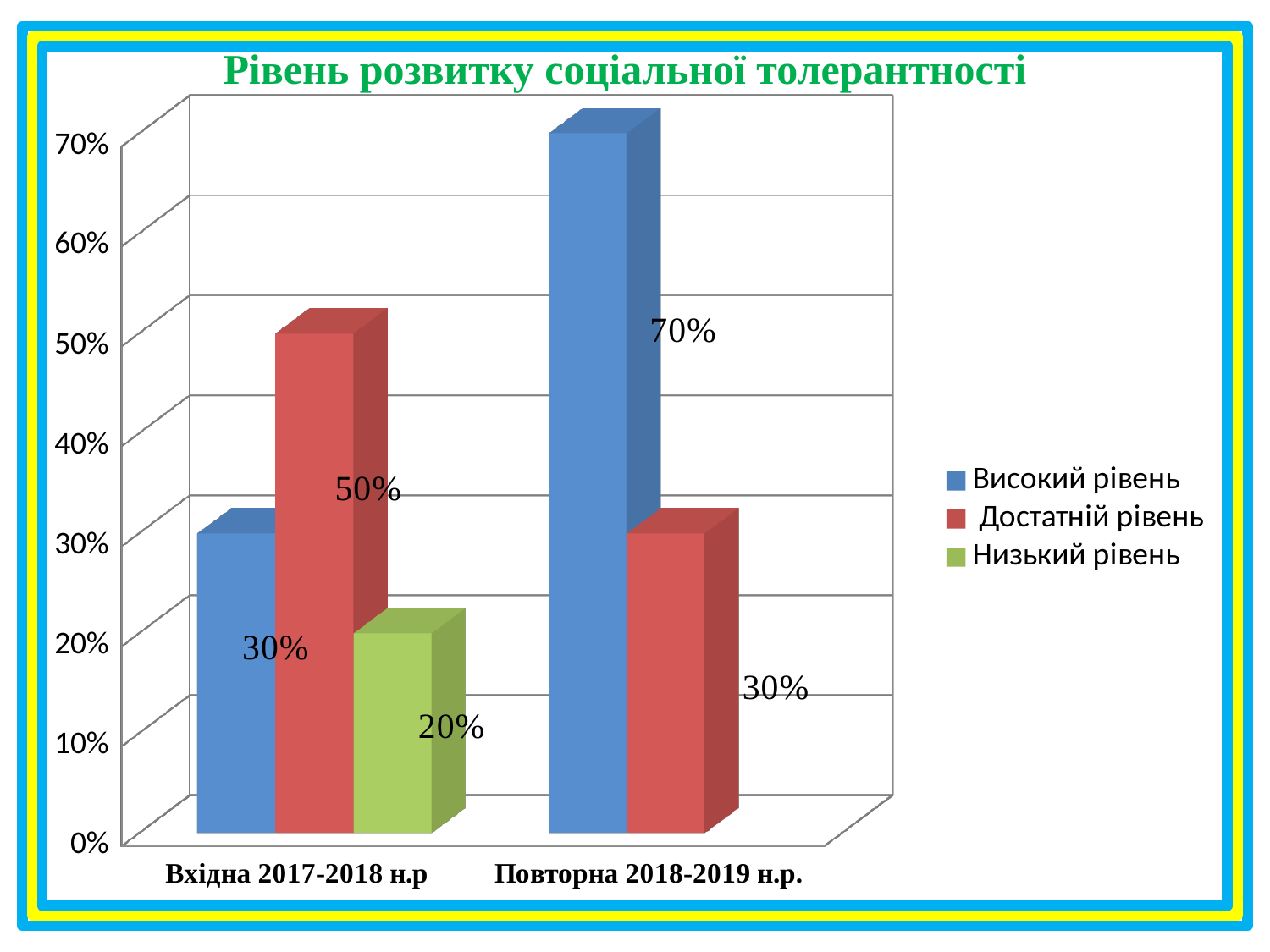
Which is larger: Достатній рівень in Вхідна 2017-2018 н.р or Достатній рівень in Повторна 2018-2019 н.р.? Вхідна 2017-2018 н.р What is the value for Достатній рівень in Вхідна 2017-2018 н.р? 50% Which series has the highest value in Повторна 2018-2019 н.р.? Високий рівень What is the difference between the Високий рівень values for Повторна 2018-2019 н.р. and Вхідна 2017-2018 н.р? 40% How many series does the legend list? 3 What is the value for Достатній рівень in Повторна 2018-2019 н.р.? 30% What is the title of the chart? Рівень розвитку соціальної толерантності Which series has the lowest value in Вхідна 2017-2018 н.р? Низький рівень What is the value for Низький рівень in Вхідна 2017-2018 н.р? 20% What kind of chart is shown on the slide? Bar chart What is the value for Високий рівень in Вхідна 2017-2018 н.р? 30% What is the value for Високий рівень in Повторна 2018-2019 н.р.? 70%